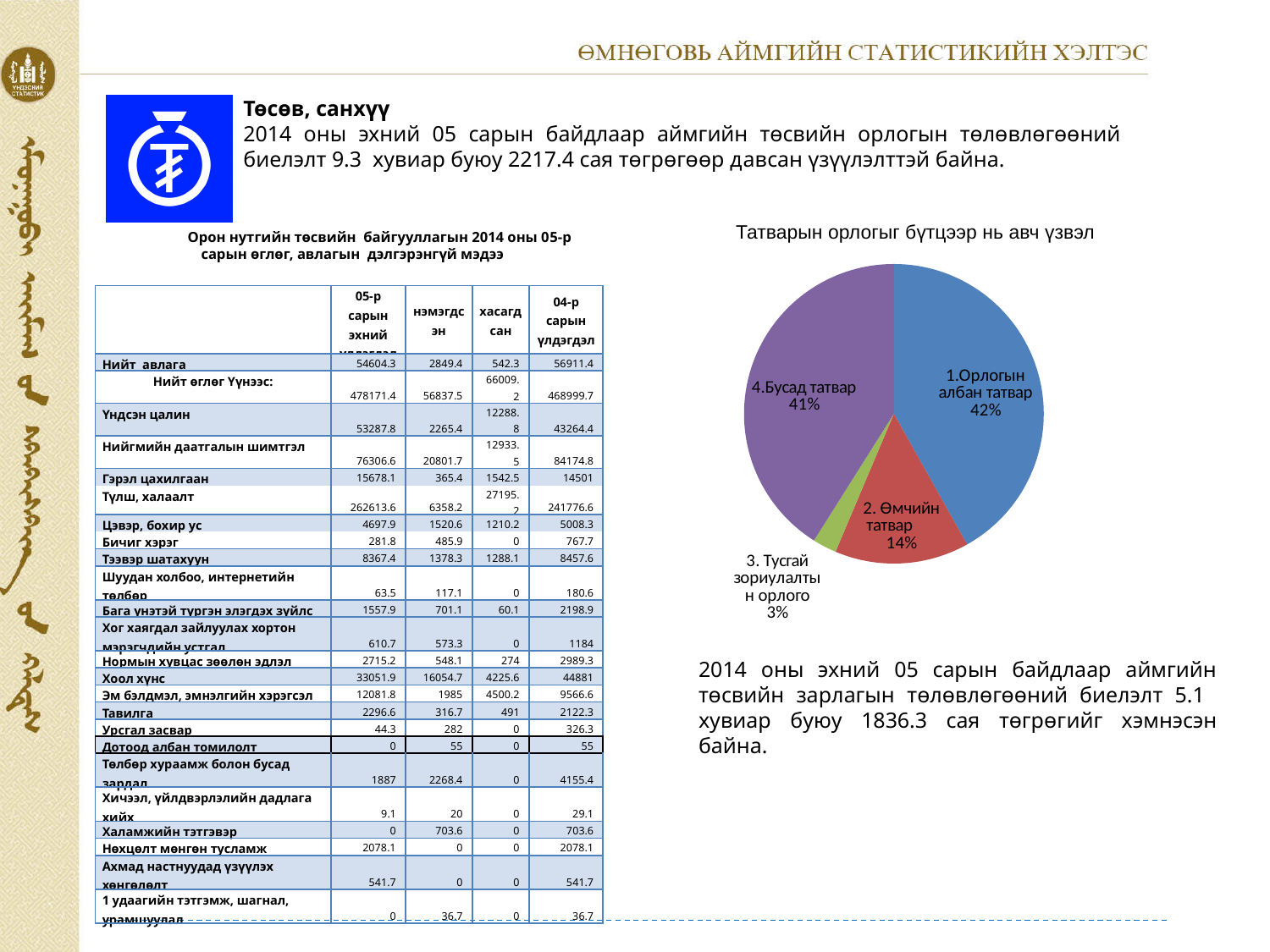
What share of the pie is 3. Тусгай зориулалтын орлого? 3% What share of the pie is 1.Орлогын албан татвар? 42% What share of the pie is 4.Бусад татвар? 41% What kind of chart is shown on the slide? pie chart Which is larger in the pie chart: 2. Өмчийн татвар or 3. Тусгай зориулалтын орлого? 2. Өмчийн татвар How many slices does the pie chart have? 4 What is the title of the pie chart? Татварын орлогыг бүтцээр нь авч үзвэл What colour is the 4.Бусад татвар slice in the pie chart? purple Which slice of the pie chart is the largest? 1.Орлогын албан татвар What is the difference in percentage points between 1.Орлогын албан татвар and 2. Өмчийн татвар? 28 Which slice of the pie chart is the smallest? 3. Тусгай зориулалтын орлого